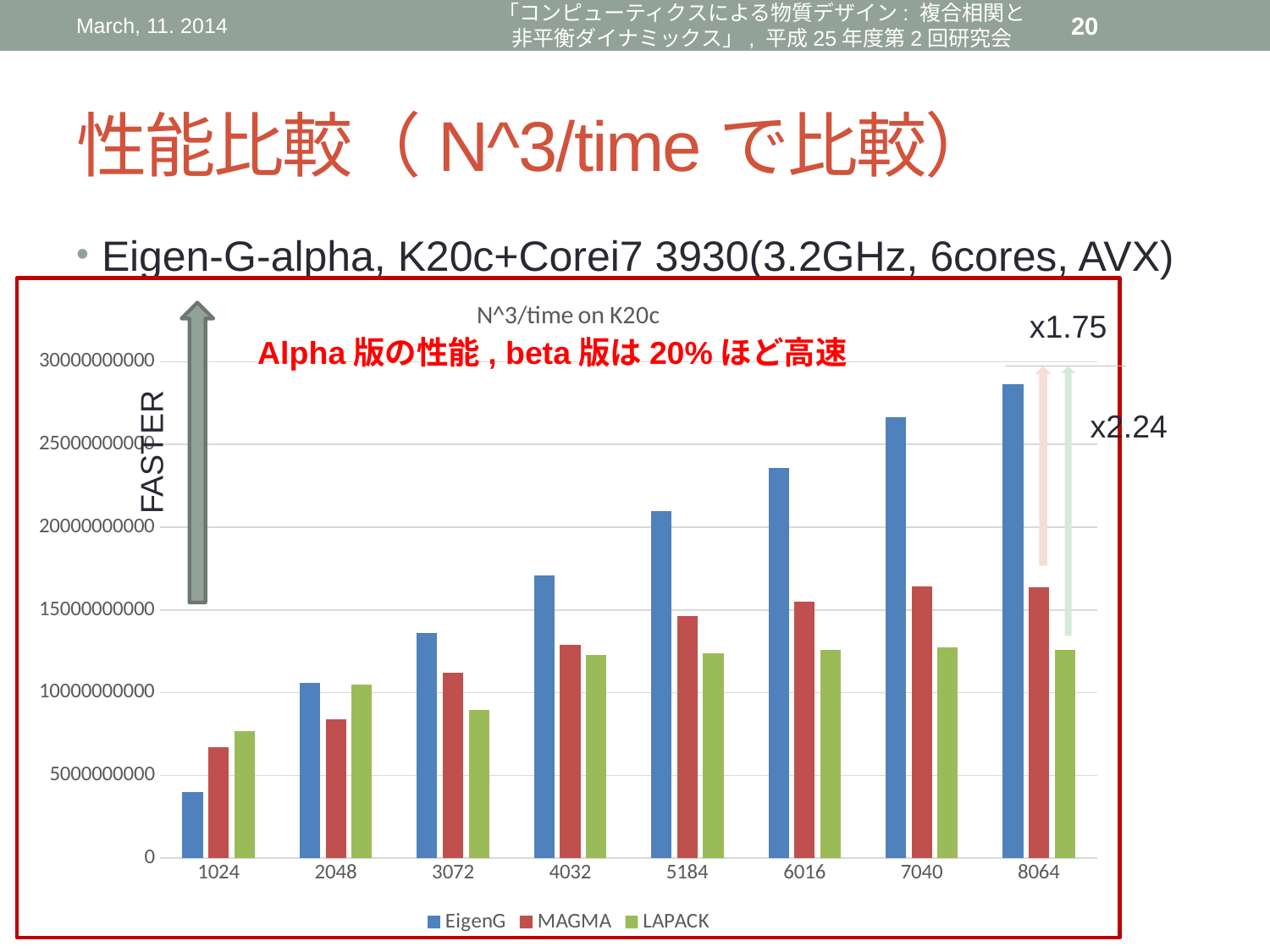
At category 1024, which is larger: the EigenG value or the LAPACK value? LAPACK How many categories are shown on the x axis of the chart? 8 How many series does the chart's legend list? 3 Is the EigenG value at 8064 greater or less than 25000000000? greater Is the LAPACK value at 8064 greater or less than 15000000000? less What is the title of the chart? N^3/time on K20c Is the EigenG value at 1024 greater or less than 5000000000? less What kind of chart is shown on the slide? bar chart At which category does the EigenG series have its lowest value? 1024 At which category does the EigenG series reach its highest value? 8064 Do the EigenG values rise or fall as the x axis goes from 1024 to 8064? rise Which series are listed in the chart's legend? EigenG, MAGMA, LAPACK